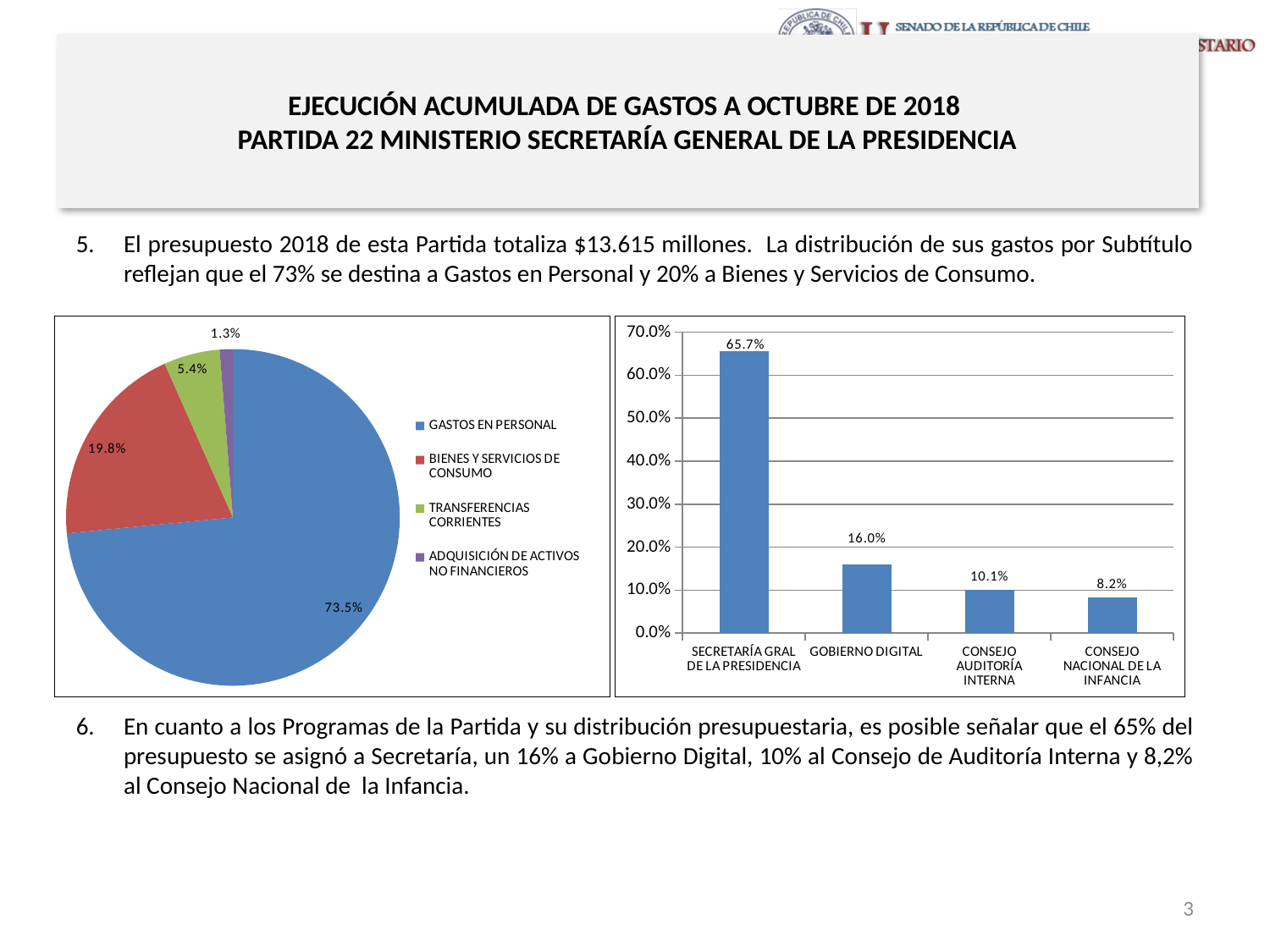
In the bar chart on the right, what is the value for GOBIERNO DIGITAL? 16.0% What kind of chart is the chart on the right of the slide? Bar chart In the pie chart on the left, what is the value for BIENES Y SERVICIOS DE CONSUMO? 19.8% In the pie chart on the left, what share does GASTOS EN PERSONAL have? 73.5% In the bar chart on the right, which category has the highest value? SECRETARÍA GRAL DE LA PRESIDENCIA In the pie chart on the left, which category has the smallest slice? ADQUISICIÓN DE ACTIVOS NO FINANCIEROS In the bar chart on the right, do the values rise or fall from left to right along the x axis? Fall In the bar chart on the right, which is larger: CONSEJO AUDITORÍA INTERNA or CONSEJO NACIONAL DE LA INFANCIA? CONSEJO AUDITORÍA INTERNA How many categories does the legend of the pie chart on the left list? 4 In the bar chart on the right, what is the difference between SECRETARÍA GRAL DE LA PRESIDENCIA and CONSEJO NACIONAL DE LA INFANCIA? 57.5% In the bar chart on the right, is the value for SECRETARÍA GRAL DE LA PRESIDENCIA greater or less than 60.0%? greater In the pie chart on the left, what is the difference between the shares of TRANSFERENCIAS CORRIENTES and ADQUISICIÓN DE ACTIVOS NO FINANCIEROS? 4.1%